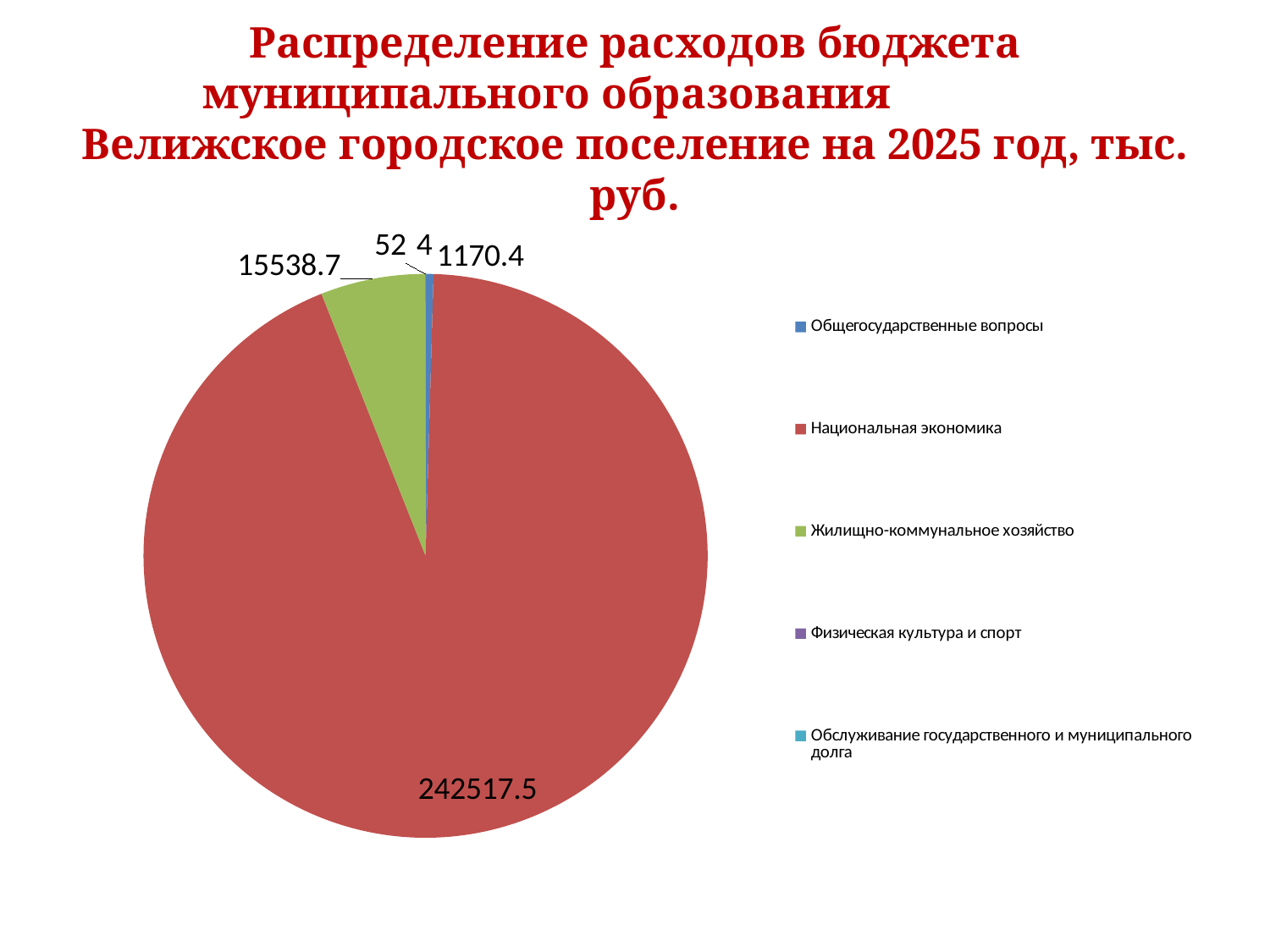
What is the value for Жилищно-коммунальное хозяйство? 15538.7 What is the value for Общегосударственные вопросы? 1170.4 Which is larger: Жилищно-коммунальное хозяйство or Общегосударственные вопросы? Жилищно-коммунальное хозяйство For which year does the slide title say the budget expenditures are distributed? 2025 What kind of chart is shown on the slide? pie chart How many categories does the legend of the pie chart list? 5 Which category has the largest share of the pie? Национальная экономика What colour is the slice for Национальная экономика? red What is the difference between the values for Жилищно-коммунальное хозяйство and Общегосударственные вопросы? 14368.3 What is the difference between the values for Национальная экономика and Жилищно-коммунальное хозяйство? 226978.8 What is the value for Национальная экономика? 242517.5